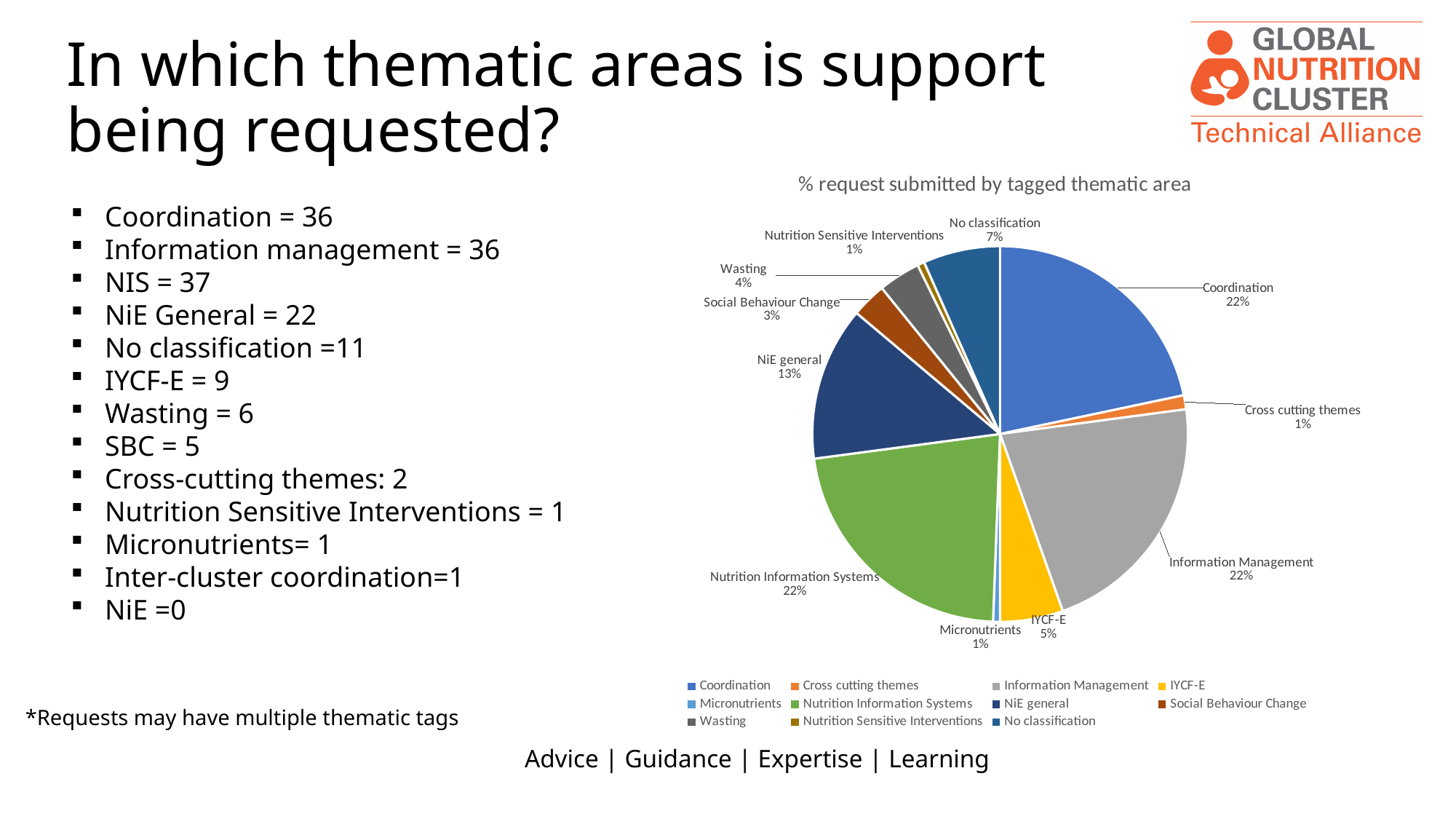
What percentage is shown for No classification in the pie chart? 7% What is the title of the pie chart? % request submitted by tagged thematic area How many thematic areas does the legend list? 11 What percentage does the NiE general slice show? 13% What is the value of the IYCF-E slice? 5% Which slice is larger, NiE general or No classification? NiE general What share of requests is tagged Coordination in the pie chart? 22% What percentage is shown for Wasting? 4% What is the difference in percentage points between NiE general and No classification? 6% What percentage is shown for Social Behaviour Change? 3% What kind of chart is shown on the slide? pie chart Which slice is larger, Wasting or IYCF-E? IYCF-E